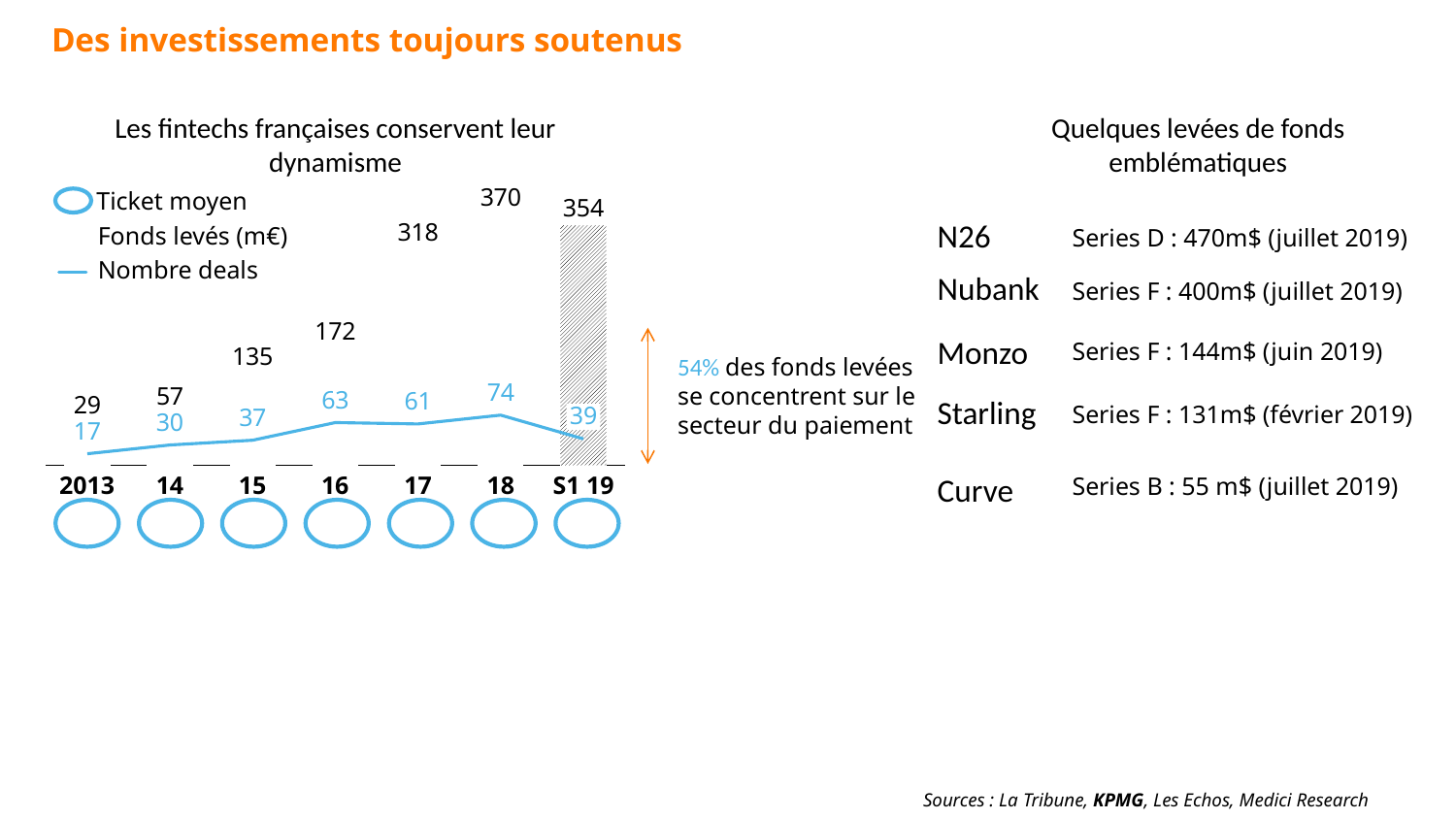
What is the value of Fonds levés (m€) for 2018? 370 What is the Fonds levés (m€) value for S1 19? 354 Which year has the highest Fonds levés (m€) value? 2018 What is the Nombre deals value for 2016? 63 How many series does the chart legend list? 3 What is the Nombre deals value for 2015? 37 What is the difference in Fonds levés (m€) between 2018 and 2017? 52 What is the title of the chart on the left of the slide? Les fintechs françaises conservent leur dynamisme How many time periods are shown on the x axis of the chart? 7 Which year has the lowest Nombre deals value? 2013 Which is larger, the Nombre deals value for 2017 or for 2018? 2018 Does the Fonds levés (m€) value rise or fall from 2013 to 2018? rise